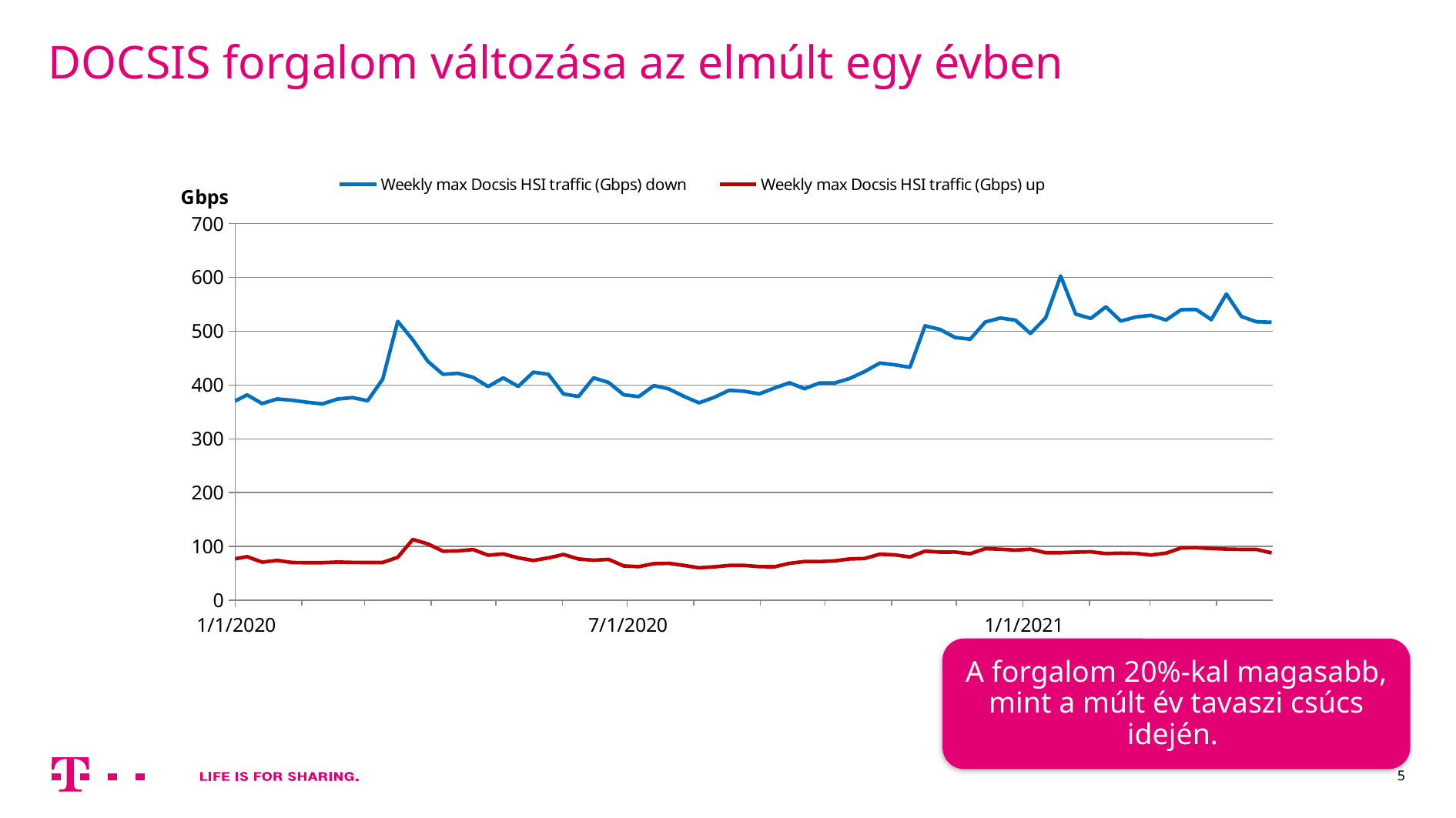
Is the value of the 'up' series at 7/1/2020 greater or less than 100? less Which series has the higher values throughout the chart, 'down' or 'up'? Weekly max Docsis HSI traffic (Gbps) down What is the highest value shown on the vertical axis? 700 Is the value of the 'down' series at 1/1/2020 greater or less than 400? less What is the label of the blue series in the legend? Weekly max Docsis HSI traffic (Gbps) down How many series does the legend list? 2 Is the value of the 'up' series at 1/1/2020 greater or less than 100? less Does the 'down' series overall rise or fall from 1/1/2020 to the end of the chart? rise What unit is shown above the vertical axis? Gbps What kind of chart is shown on the slide? line chart